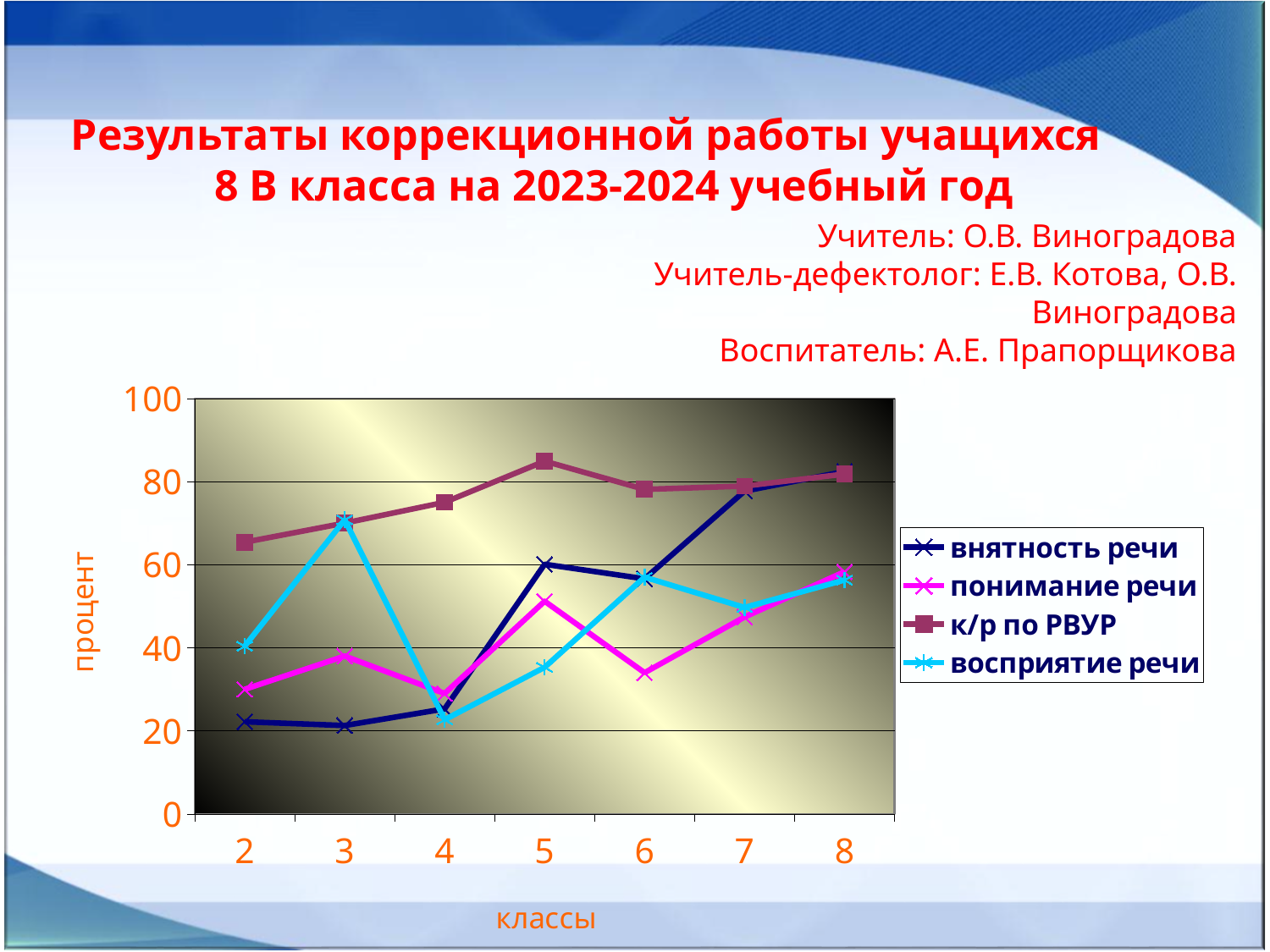
Is the value for понимание речи at class 6 greater or less than 40? less At which class does к/р по РВУР reach its highest value? 5 Is the value for восприятие речи at class 3 greater or less than 60? greater At class 2, which is higher: к/р по РВУР or внятность речи? к/р по РВУР Is the value for восприятие речи at class 4 greater or less than 40? less Does the к/р по РВУР series generally rise or fall from class 2 to class 8? rise How many series does the legend list? 4 At which class does восприятие речи have its lowest value? 4 How many classes are plotted along the x axis? 7 What kind of chart is shown on the slide? line chart What is the title of the vertical axis? процент